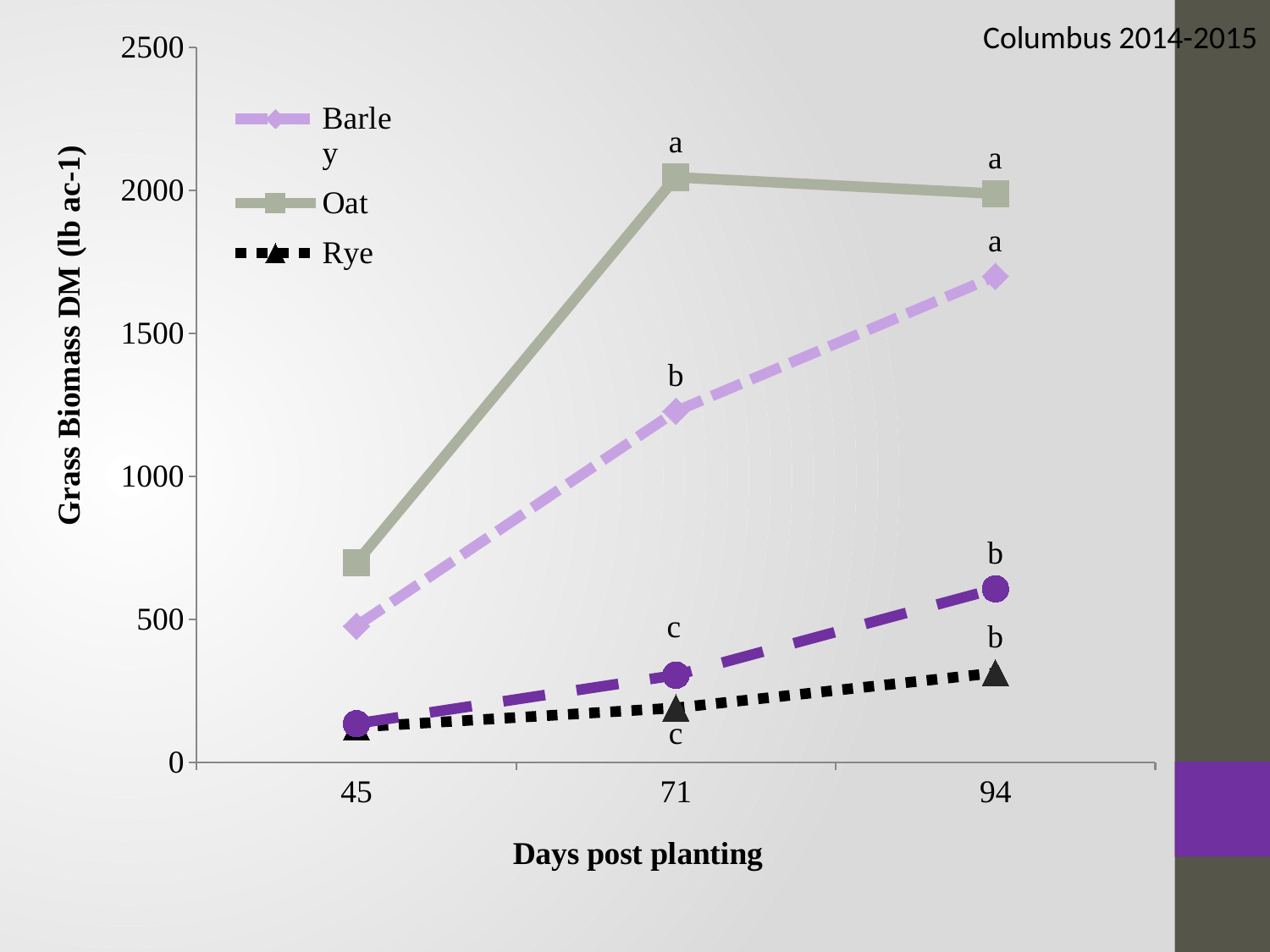
What kind of chart is shown on the slide? line chart Is the Oat value at 45 days post planting greater or less than 500? greater Does the Barley series rise or fall from 45 to 94 days post planting? rises At 71 days post planting, which is larger, the Oat value or the Barley value? Oat Is the Oat value at 71 days post planting greater or less than 1500? greater How many series does the legend list? 3 Is the Barley value at 71 days post planting greater or less than 1000? greater How many days-post-planting points are plotted along the x axis? 3 What is the title of the y axis? Grass Biomass DM (lb ac-1) Which series has the highest value at 94 days post planting? Oat